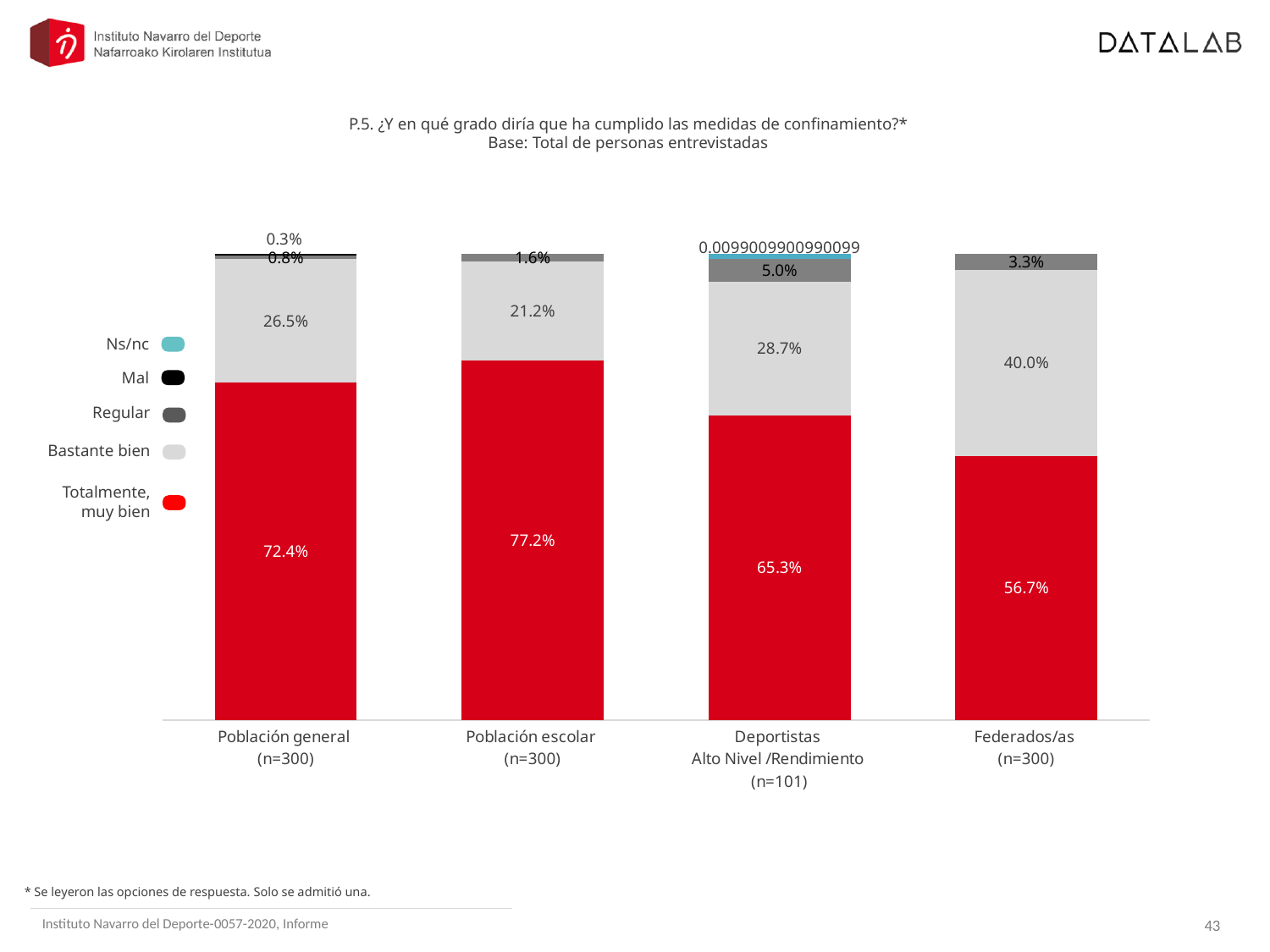
What is the value for "Bastante bien" for Federados/as (n=300)? 40.0% Which group has the highest value for "Totalmente, muy bien"? Población escolar (n=300) Which group has the lowest value for "Totalmente, muy bien"? Federados/as (n=300) Which is larger: the "Bastante bien" value for Población escolar or for Deportistas Alto Nivel /Rendimiento? Deportistas Alto Nivel /Rendimiento How many groups are shown on the x axis? 4 What kind of chart is shown on the slide? Stacked bar chart What is the value for "Regular" for Deportistas Alto Nivel /Rendimiento (n=101)? 5.0% How many series does the legend list? 5 What is the difference between the "Totalmente, muy bien" values for Población general and Federados/as? 15.7% What is the value for "Totalmente, muy bien" for Población general (n=300)? 72.4% What is the value for "Totalmente, muy bien" for Población escolar (n=300)? 77.2% Which colour represents "Totalmente, muy bien" in the legend? Red